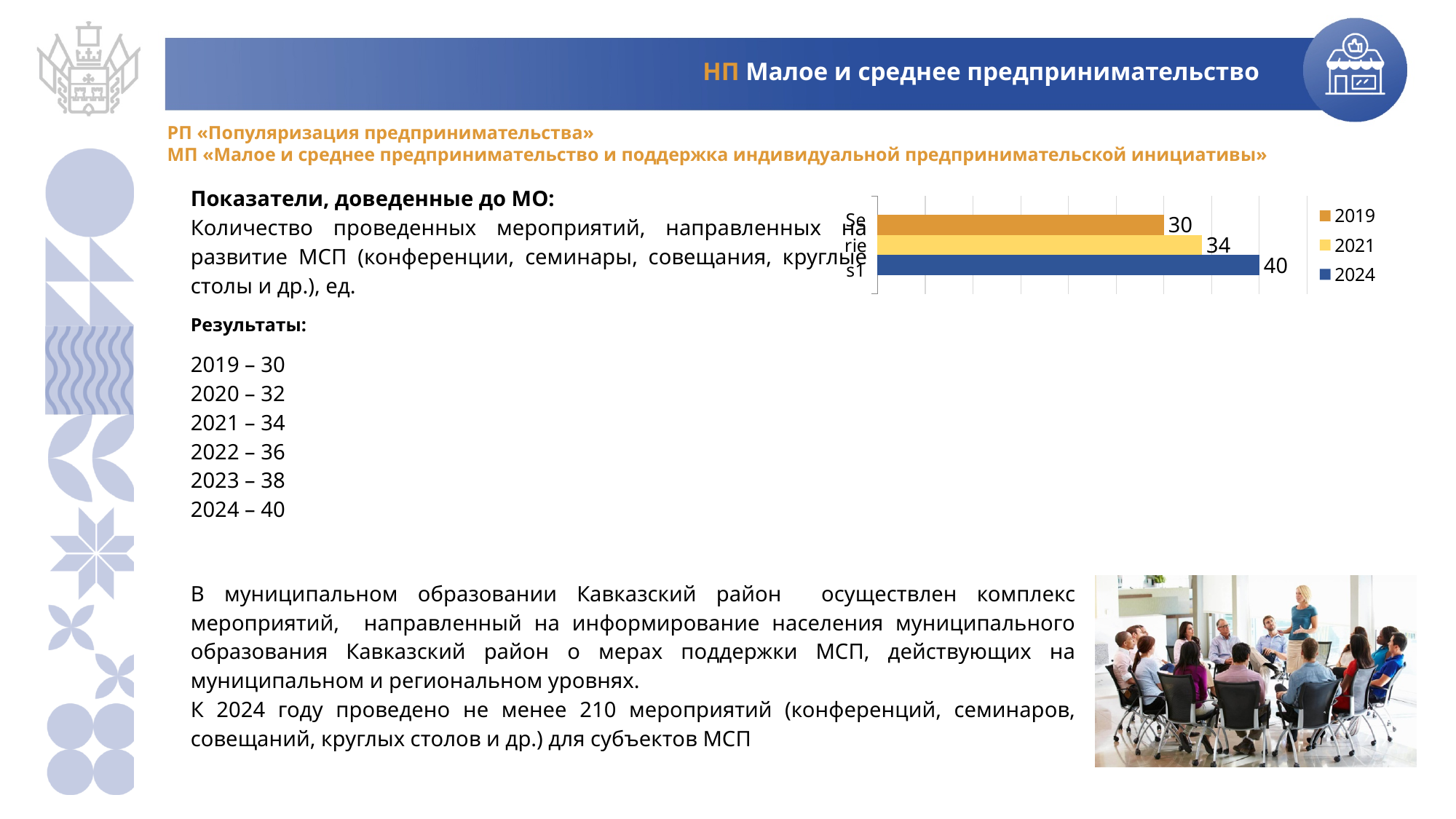
Do the values in the chart rise or fall from 2019 to 2024? rise What is the difference between the values for 2021 and 2019 in the chart? 4 What value does the chart show for 2021? 34 What value does the chart show for 2019? 30 What is the difference between the values for 2024 and 2019 in the chart? 10 How many series does the chart legend list? 3 Which is larger in the chart, the value for 2021 or the value for 2024? 2024 Which colour is used for the 2024 series in the chart? blue Which year has the highest value in the chart? 2024 What kind of chart is shown on the slide? bar chart What value does the chart show for 2024? 40 Which year has the lowest value in the chart? 2019